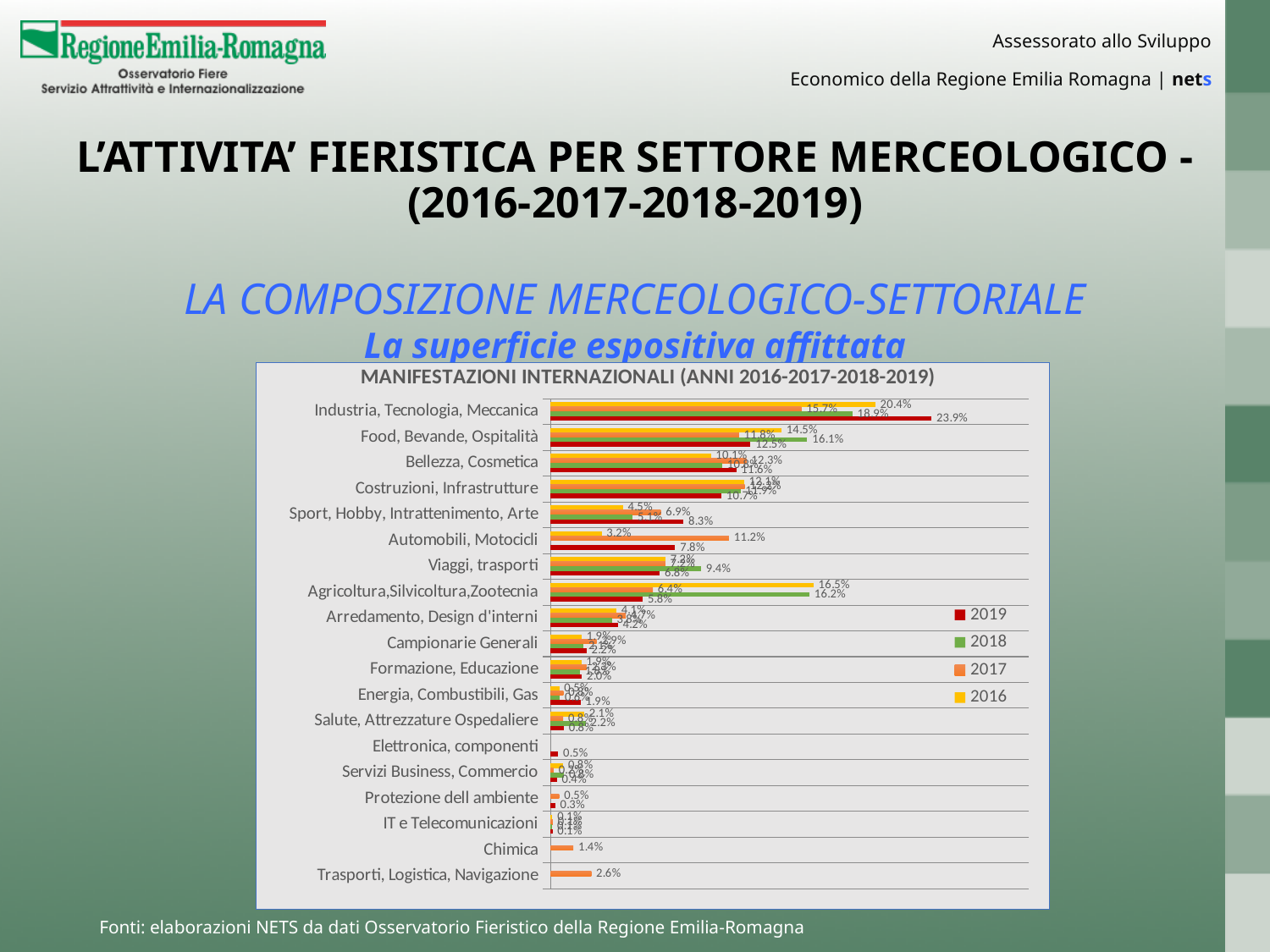
What is the 2016 value for Agricoltura,Silvicoltura,Zootecnia? 16.5% What kind of chart is shown on the slide? Bar chart How many sector categories are plotted on the chart? 19 How many series does the legend list? 4 What is the 2017 value for Automobili, Motocicli? 11.2% For Food, Bevande, Ospitalità, which is larger: the 2018 value or the 2019 value? 2018 What is the value shown for Trasporti, Logistica, Navigazione? 2.6% Which category has the highest 2019 value? Industria, Tecnologia, Meccanica What is the 2019 value for Industria, Tecnologia, Meccanica? 23.9% What is the difference between the 2019 and 2017 values for Industria, Tecnologia, Meccanica? 8.2 percentage points What is the 2018 value for Food, Bevande, Ospitalità? 16.1% What is the 2016 value for Industria, Tecnologia, Meccanica? 20.4%